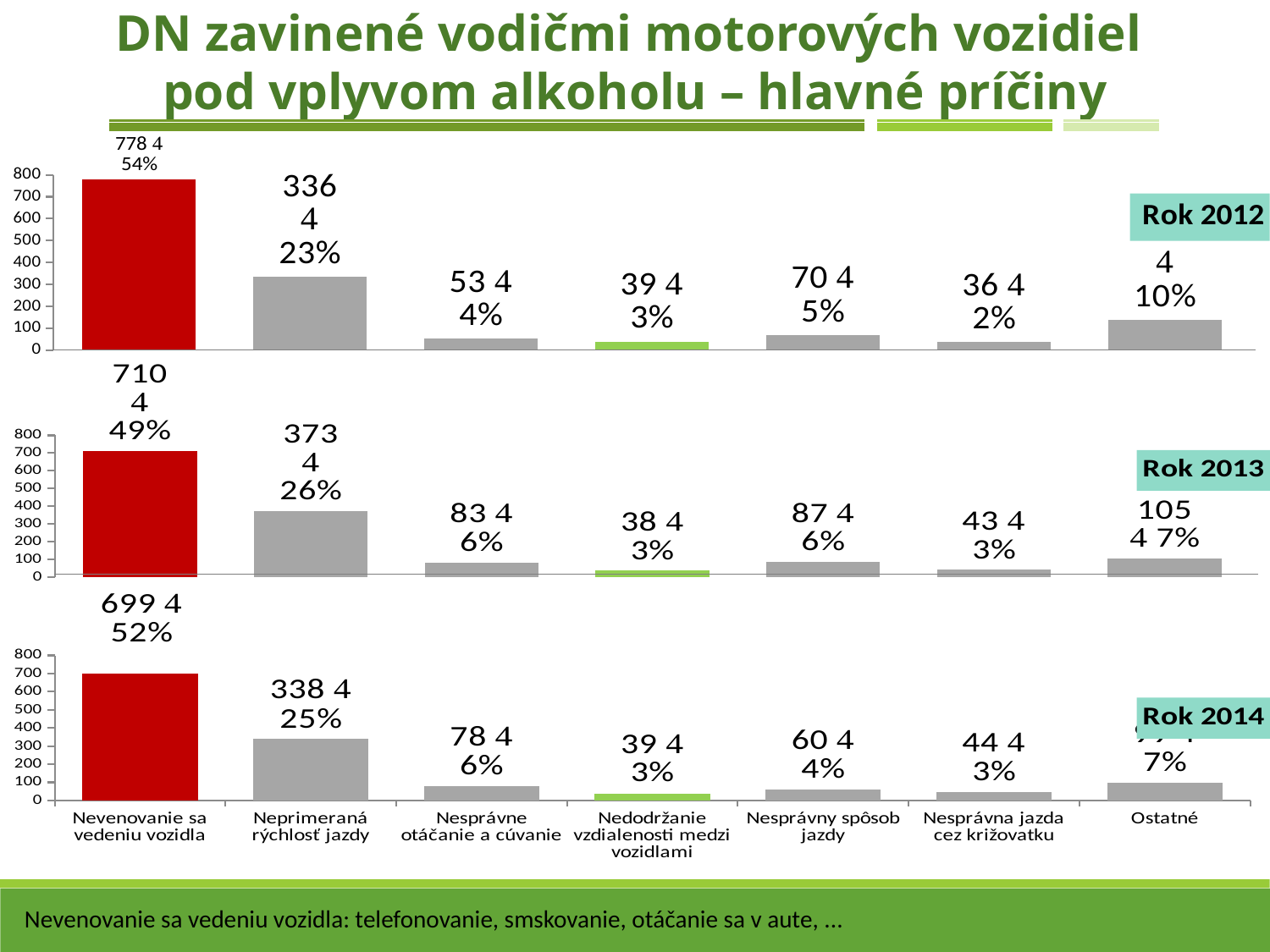
In the Rok 2012 chart, which category has the highest value? Nevenovanie sa vedeniu vozidla In the Rok 2014 chart, is the value for Neprimeraná rýchlosť jazdy greater or less than 300? greater What kind of chart is the Rok 2013 chart? bar chart In the Rok 2013 chart, what is the value for Ostatné? 105 How many categories are shown on the x axis of the Rok 2014 chart? 7 In the Rok 2014 chart, what percentage is shown for Nesprávne otáčanie a cúvanie? 6% In the Rok 2014 chart, which category has the lowest value? Nedodržanie vzdialenosti medzi vozidlami In the Rok 2012 chart, which category has the lowest value? Nesprávna jazda cez križovatku In the Rok 2012 chart, what percentage is shown for Nevenovanie sa vedeniu vozidla? 54% In the Rok 2013 chart, what percentage is shown for Neprimeraná rýchlosť jazdy? 26% In the Rok 2012 chart, what is the value for Nesprávny spôsob jazdy? 70 In the Rok 2013 chart, which is larger: Nesprávne otáčanie a cúvanie or Nesprávny spôsob jazdy? Nesprávny spôsob jazdy